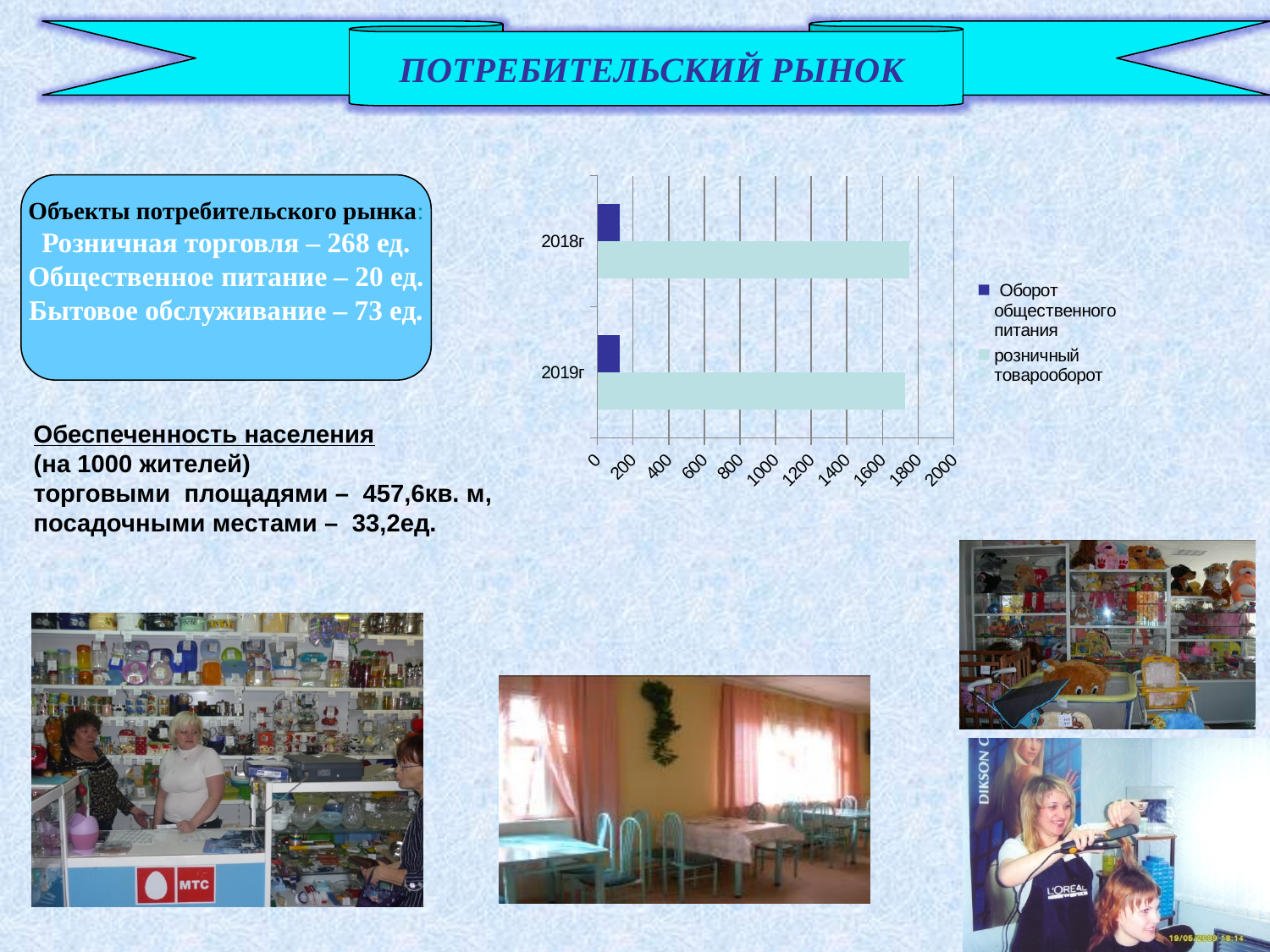
For 2019г, which is larger: розничный товарооборот or Оборот общественного питания? розничный товарооборот Which years are shown as categories on the chart? 2018г and 2019г What is the maximum value shown on the chart's value axis? 2000 How many years (categories) are shown on the chart? 2 How many series does the chart legend list? 2 Is the value of розничный товарооборот for 2018г greater or less than 1600? greater For 2018г, which series has the smaller value? Оборот общественного питания Which series is drawn in dark blue on the chart? Оборот общественного питания What kind of chart is shown on the slide? bar chart Is the value of розничный товарооборот for 2019г greater or less than 1400? greater Is the value of Оборот общественного питания for 2018г greater or less than 200? less